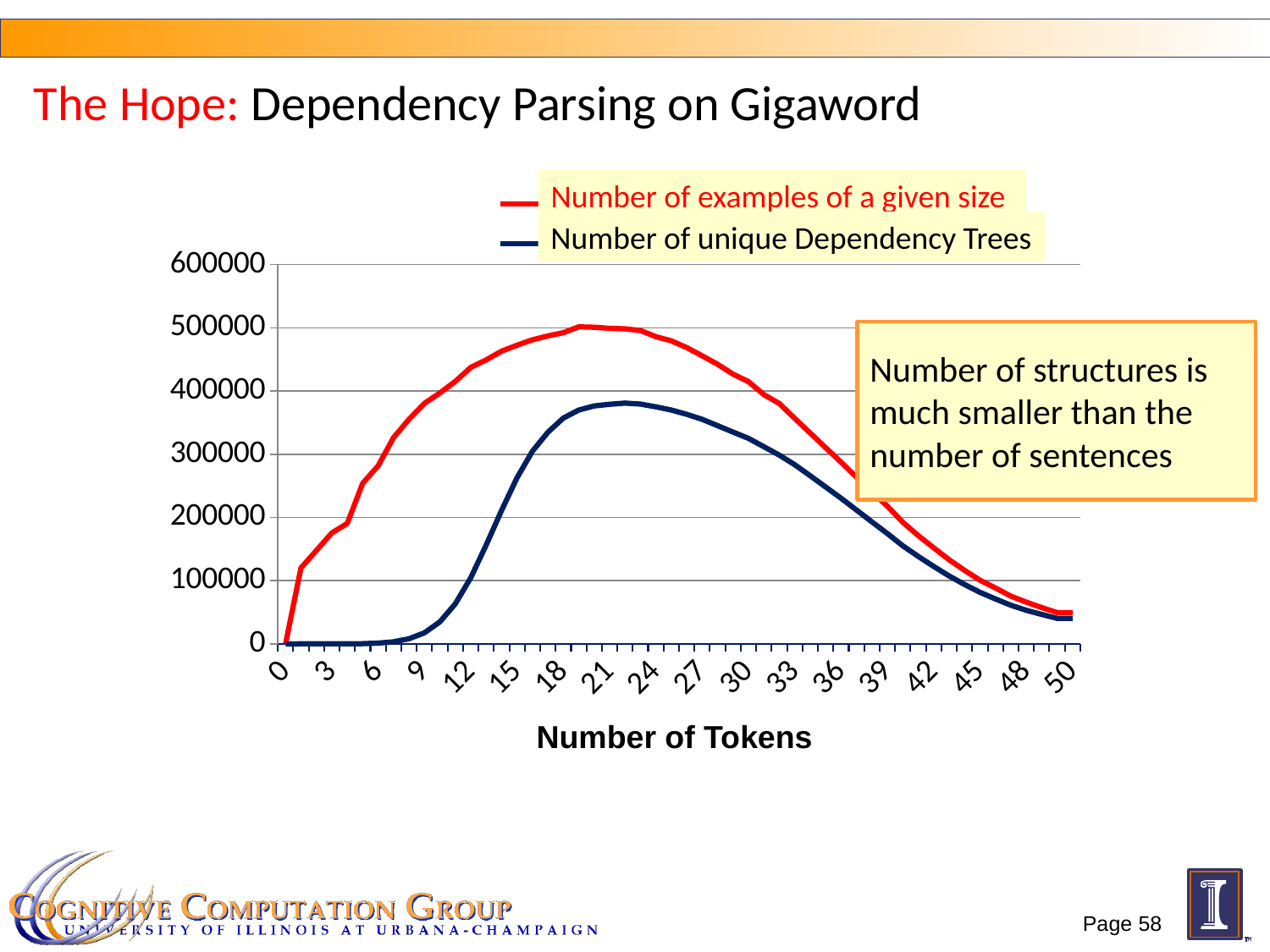
Which series is drawn in red? Number of examples of a given size Does the 'Number of examples of a given size' series rise or fall between 24 and 50 tokens? fall Is the value of 'Number of examples of a given size' at 50 tokens greater or less than 100000? less Which series reaches the higher peak value? Number of examples of a given size How many series does the legend list? 2 What kind of chart is shown on the slide? line chart At 12 tokens, which series has the larger value: 'Number of examples of a given size' or 'Number of unique Dependency Trees'? Number of examples of a given size Is the value of 'Number of unique Dependency Trees' at 9 tokens greater or less than 100000? less Is the value of 'Number of unique Dependency Trees' at 21 tokens greater or less than 400000? less What is the title of the x axis? Number of Tokens